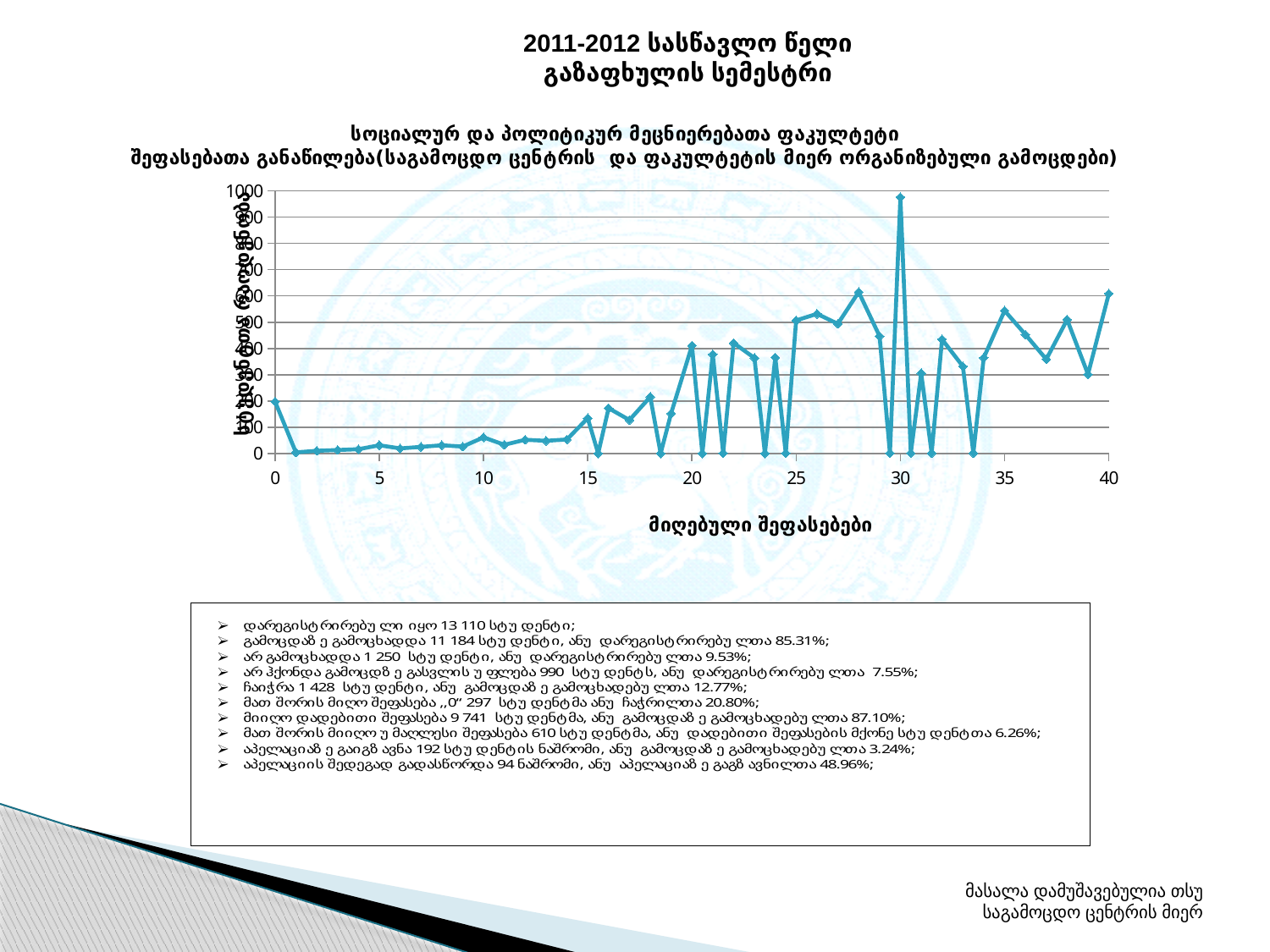
Is the value at x = 20 greater or less than 300? greater Which has the larger value, the point at x = 30 or the point at x = 40? x = 30 At which x-axis value does the line reach its highest point? 30 Is the value at x = 1 greater or less than 100? less What is the highest value shown on the y axis? 1000 Is the value at x = 40 greater or less than 500? greater What is the label of the x axis? მიღებული შეფასებები Which has the larger value, the point at x = 0 or the point at x = 10? x = 0 What kind of chart is shown on the slide? line chart Overall, do the values rise or fall as the x axis goes from 0 to 40? rise